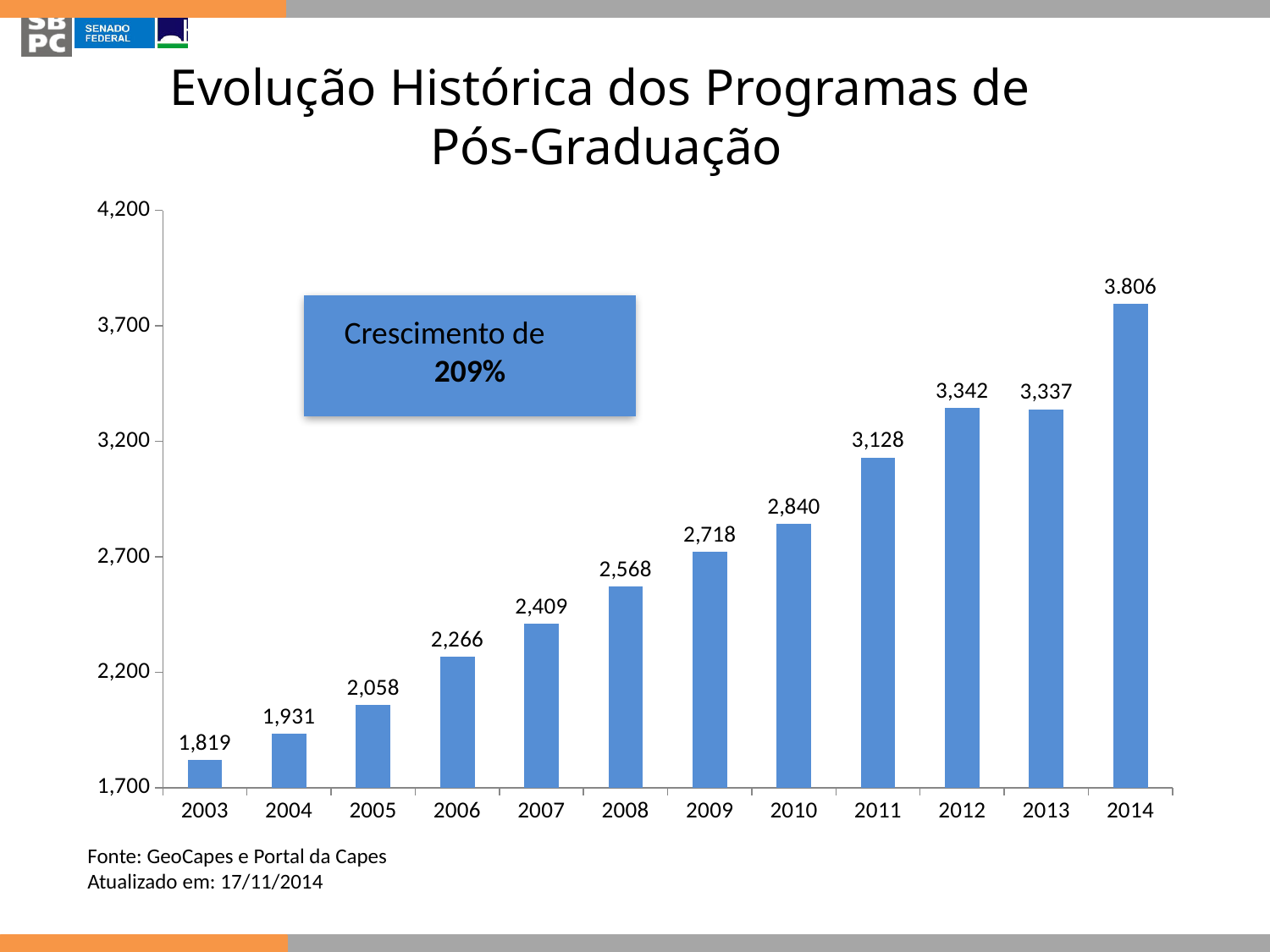
What is the difference between the values for 2011 and 2010? 288 Which year has the lowest value? 2003 What is the value for 2003? 1,819 Which year has the highest value? 2014 What is the difference between the values for 2004 and 2003? 112 What is the value for 2014? 3.806 What type of chart is shown on the slide? bar chart How many years are shown on the x axis? 12 What is the value for 2009? 2,718 Which is larger, the value for 2012 or the value for 2013? 2012 Do the values generally rise or fall from 2003 to 2014? rise What growth percentage is stated in the text box on the chart? 209%